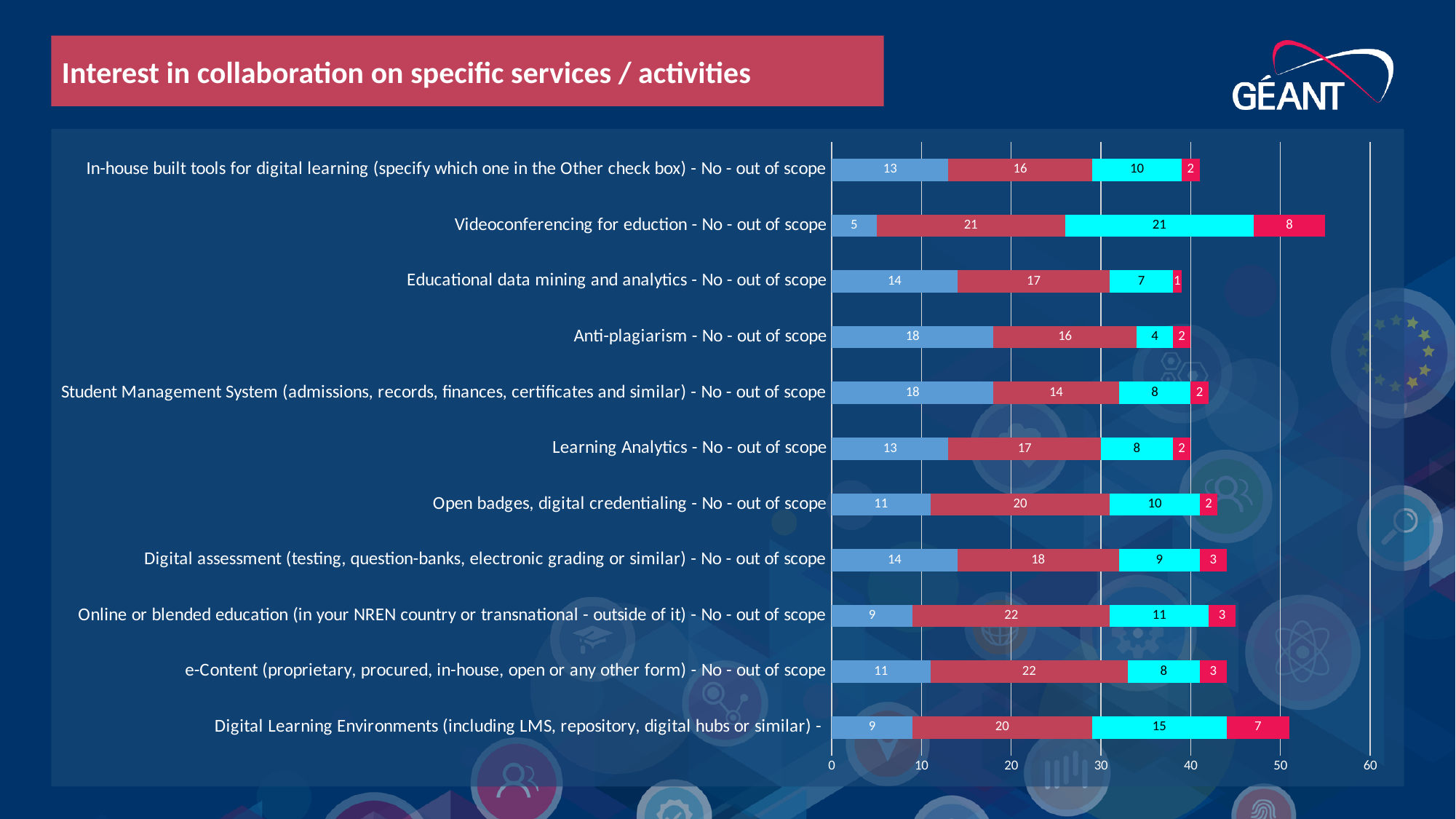
What is the total of the stacked bar for 'Videoconferencing for eduction - No - out of scope'? 55 Which is larger: the blue segment for 'Student Management System (admissions, records, finances, certificates and similar) - No - out of scope' or the blue segment for 'Open badges, digital credentialing - No - out of scope'? Student Management System (admissions, records, finances, certificates and similar) - No - out of scope What kind of chart is shown on the slide? stacked bar chart What is the total of the stacked bar for 'Educational data mining and analytics - No - out of scope'? 39 What is the value of the pink (last) segment for 'Digital Learning Environments (including LMS, repository, digital hubs or similar) -'? 7 How many categories (bars) does the chart show? 11 What is the value of the blue segment for 'Anti-plagiarism - No - out of scope'? 18 Is the total length of the bar for 'Digital Learning Environments (including LMS, repository, digital hubs or similar) -' greater or less than 50? greater What is the value of the red segment for 'e-Content (proprietary, procured, in-house, open or any other form) - No - out of scope'? 22 Which category has the longest stacked bar overall? Videoconferencing for eduction - No - out of scope What is the difference between the red segment and the blue segment for 'Online or blended education (in your NREN country or transnational - outside of it) - No - out of scope'? 13 What is the value of the cyan segment for 'Videoconferencing for eduction - No - out of scope'? 21